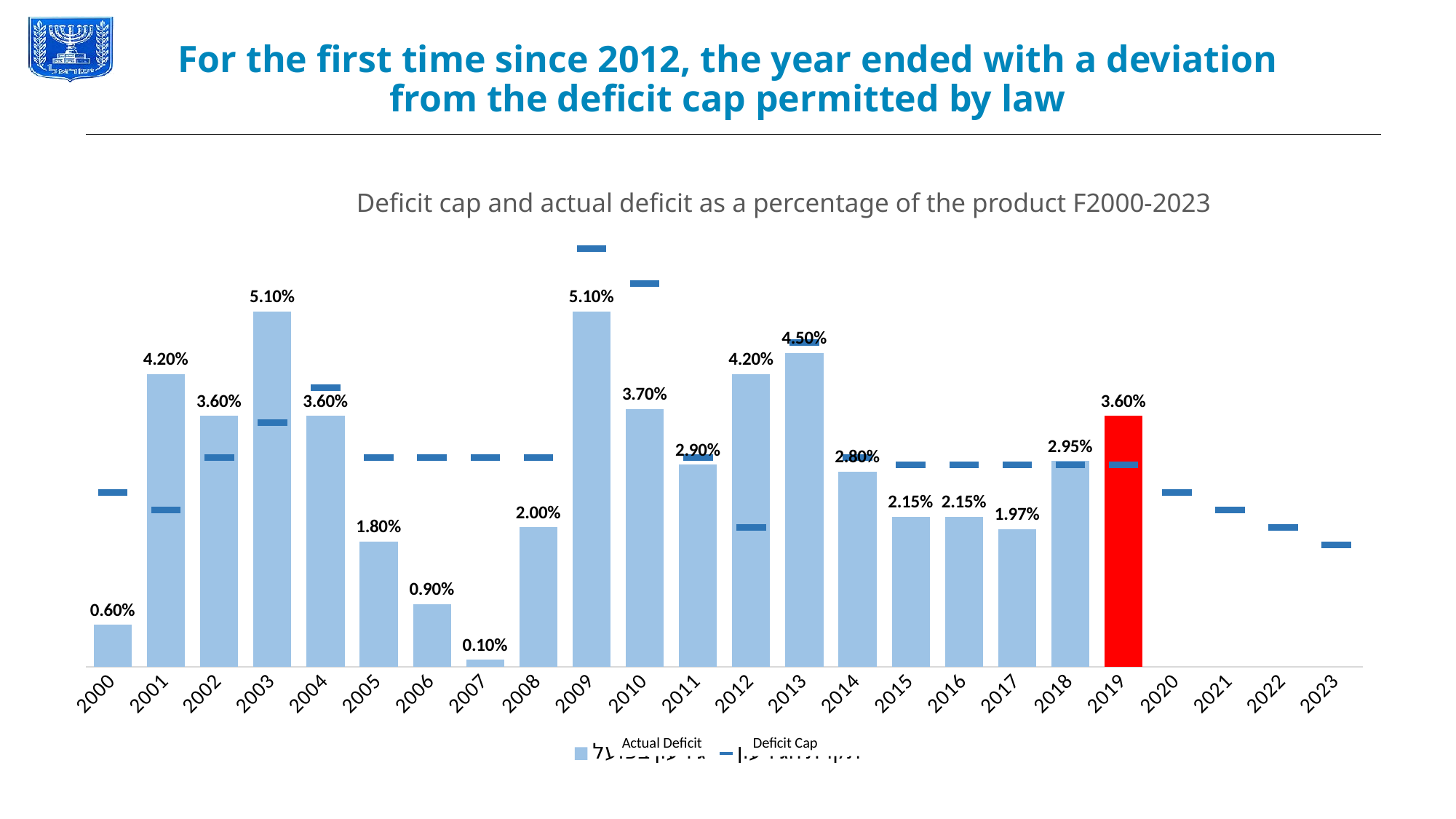
What is the actual deficit value shown for 2019? 3.60% Which year's actual deficit bar is coloured red? 2019 Which year has the larger actual deficit, 2010 or 2011? 2010 Which year has the lowest actual deficit bar? 2007 What is the highest actual deficit value labelled on the chart? 5.10% How many series does the legend list? 2 What is the actual deficit value shown for 2017? 1.97% What is the actual deficit value shown for 2007? 0.10% How many years have an actual deficit bar plotted? 20 What kind of chart is shown on the slide? Combination bar and line chart (bars for actual deficit, dash markers for deficit cap) What is the difference between the actual deficit in 2019 and in 2018? 0.65% What is the actual deficit value shown for 2013? 4.50%